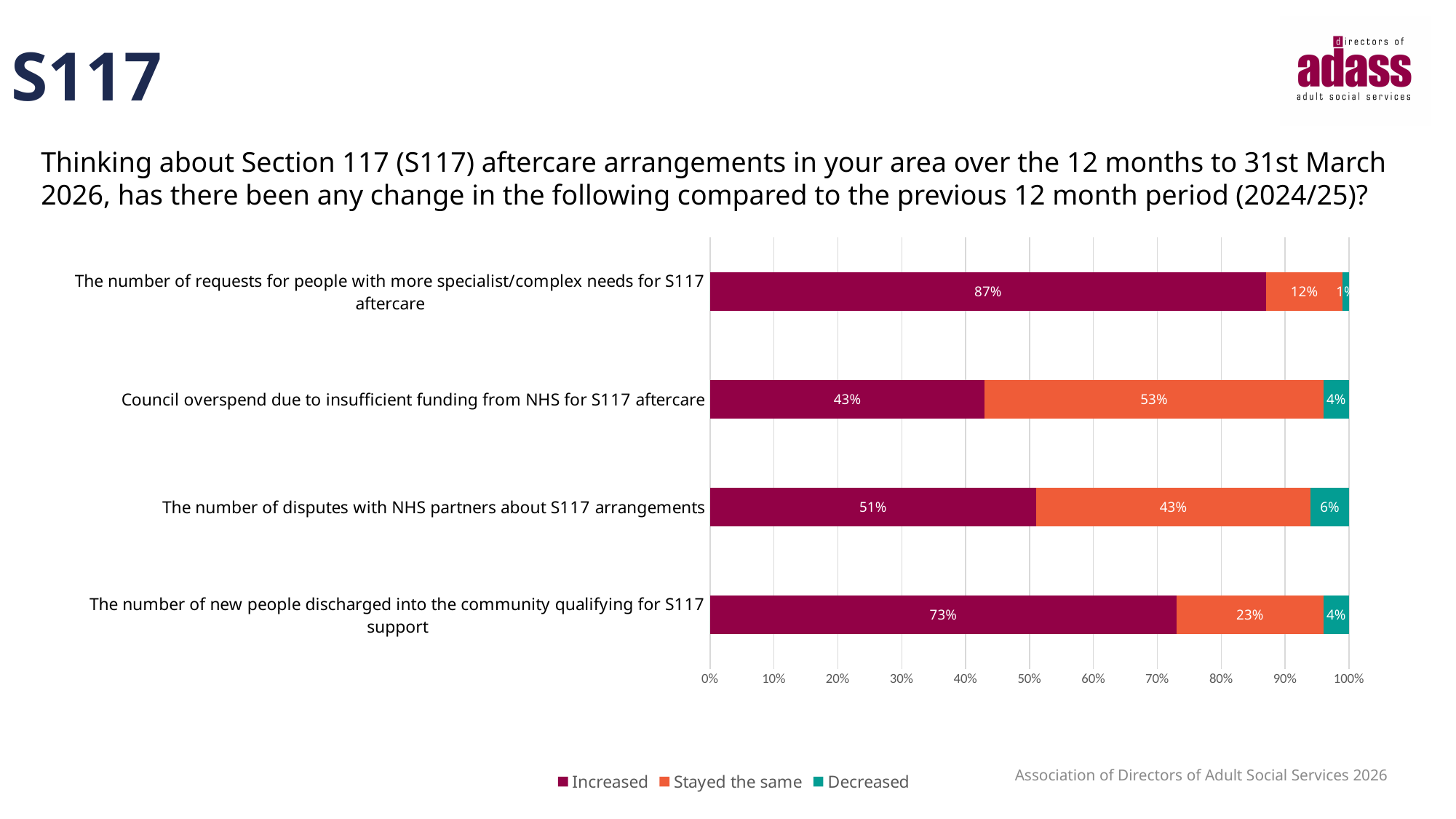
What is the difference between the 'Increased' percentages for the number of new people discharged into the community qualifying for S117 support and council overspend due to insufficient funding from NHS for S117 aftercare? 30% Which series is shown in teal in the legend? Decreased What percentage reported that the number of requests for people with more specialist/complex needs for S117 aftercare increased? 87% Which category has the lowest 'Increased' percentage? Council overspend due to insufficient funding from NHS for S117 aftercare How many categories are shown in the chart? 4 What percentage reported that council overspend due to insufficient funding from NHS for S117 aftercare stayed the same? 53% How many series does the legend list? 3 What percentage reported that the number of new people discharged into the community qualifying for S117 support increased? 73% For the number of disputes with NHS partners about S117 arrangements, which is larger: 'Increased' or 'Stayed the same'? Increased What percentage reported that the number of disputes with NHS partners about S117 arrangements decreased? 6% What kind of chart is shown on the slide? Stacked bar chart Which category has the highest 'Increased' percentage? The number of requests for people with more specialist/complex needs for S117 aftercare